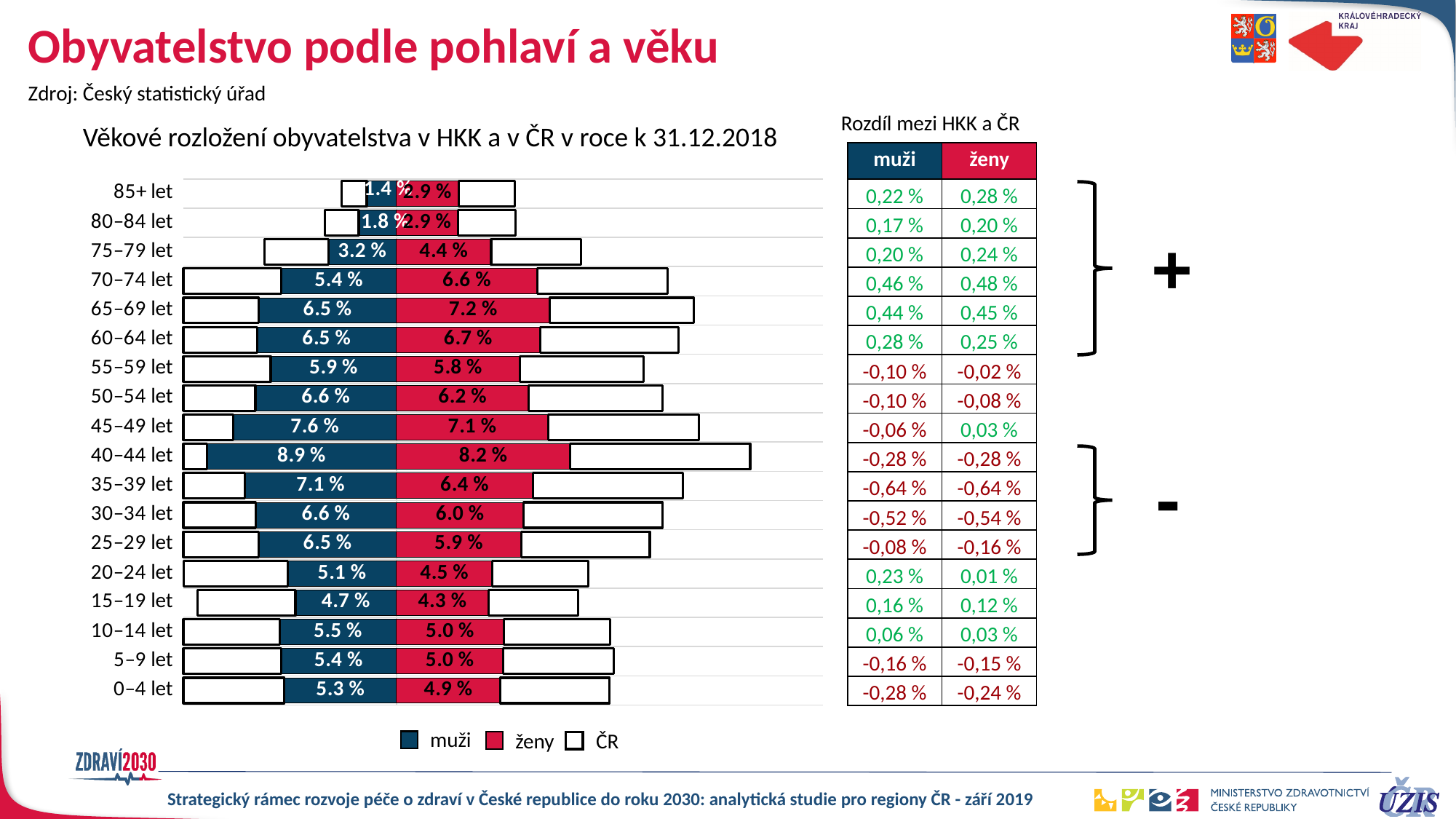
Which age group has the highest value for muži? 40–44 let What is the value for muži in the 0–4 let age group? 5.3 % What is the value for ženy in the 65–69 let age group? 7.2 % How many entries does the chart legend list? 3 What is the value for ženy in the 85+ let age group? 2.9 % What is the value for muži in the 40–44 let age group? 8.9 % In the 45–49 let age group, which is larger, the value for muži or for ženy? muži What is the difference between the muži and ženy values in the 40–44 let age group? 0.7 % Which age group has the lowest value for muži? 85+ let How many age groups are shown in the chart? 18 Which age group has the highest value for ženy? 40–44 let What type of chart is shown on the slide? bar chart